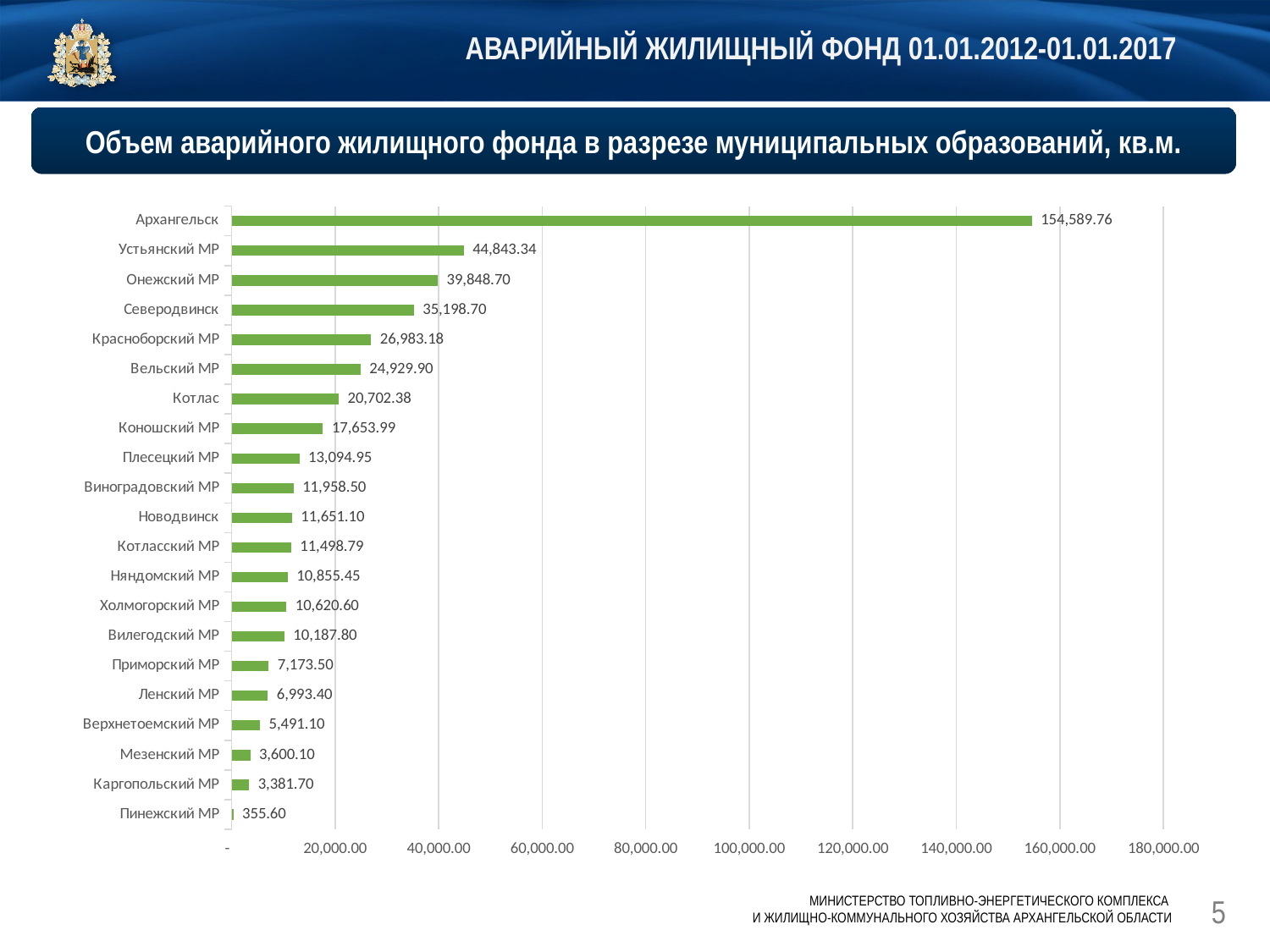
What is the value for Котлас? 20,702.38 Which municipality has the lowest value? Пинежский МР What is the difference between the values for Архангельск and Устьянский МР? 109,746.42 What kind of chart is shown on the slide? bar chart Is the value for Устьянский МР greater or less than 40,000.00? greater How many municipalities are shown in the chart? 21 Which municipality has the highest value? Архангельск Which is larger, the value for Вельский МР or the value for Коношский МР? Вельский МР What is the value for Пинежский МР? 355.60 What is the title of the chart? Объем аварийного жилищного фонда в разрезе муниципальных образований, кв.м. What is the value for Архангельск? 154,589.76 What is the difference between the values for Онежский МР and Северодвинск? 4,650.00